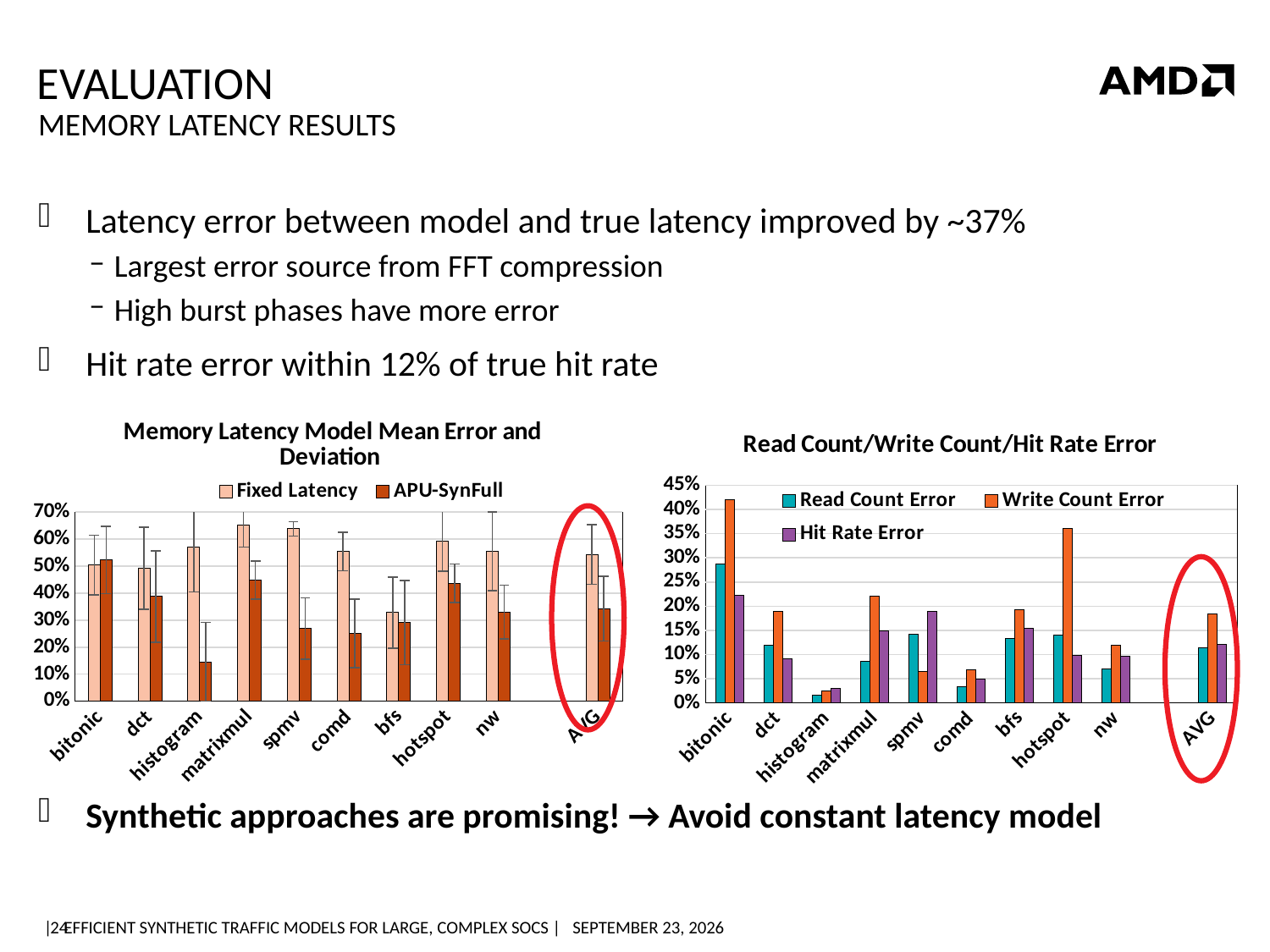
In the "Memory Latency Model Mean Error and Deviation" chart, is the APU-SynFull value for histogram greater or less than 20%? less What type of chart is the "Memory Latency Model Mean Error and Deviation" chart? bar chart How many categories are shown on the x axis of the "Memory Latency Model Mean Error and Deviation" chart? 10 How many series does the legend of the "Memory Latency Model Mean Error and Deviation" chart list? 2 In the "Memory Latency Model Mean Error and Deviation" chart, for spmv, which is larger: Fixed Latency or APU-SynFull? Fixed Latency In the "Read Count/Write Count/Hit Rate Error" chart, is the Write Count Error for hotspot greater or less than 30%? greater Which category is circled in red on both charts? AVG How many series does the legend of the "Read Count/Write Count/Hit Rate Error" chart list? 3 In the "Memory Latency Model Mean Error and Deviation" chart, which category has the lowest APU-SynFull value? histogram In the "Read Count/Write Count/Hit Rate Error" chart, for spmv, which is larger: Read Count Error or Write Count Error? Read Count Error In the "Memory Latency Model Mean Error and Deviation" chart, which category has the lowest Fixed Latency value? bfs In the "Read Count/Write Count/Hit Rate Error" chart, which category has the highest Write Count Error? bitonic